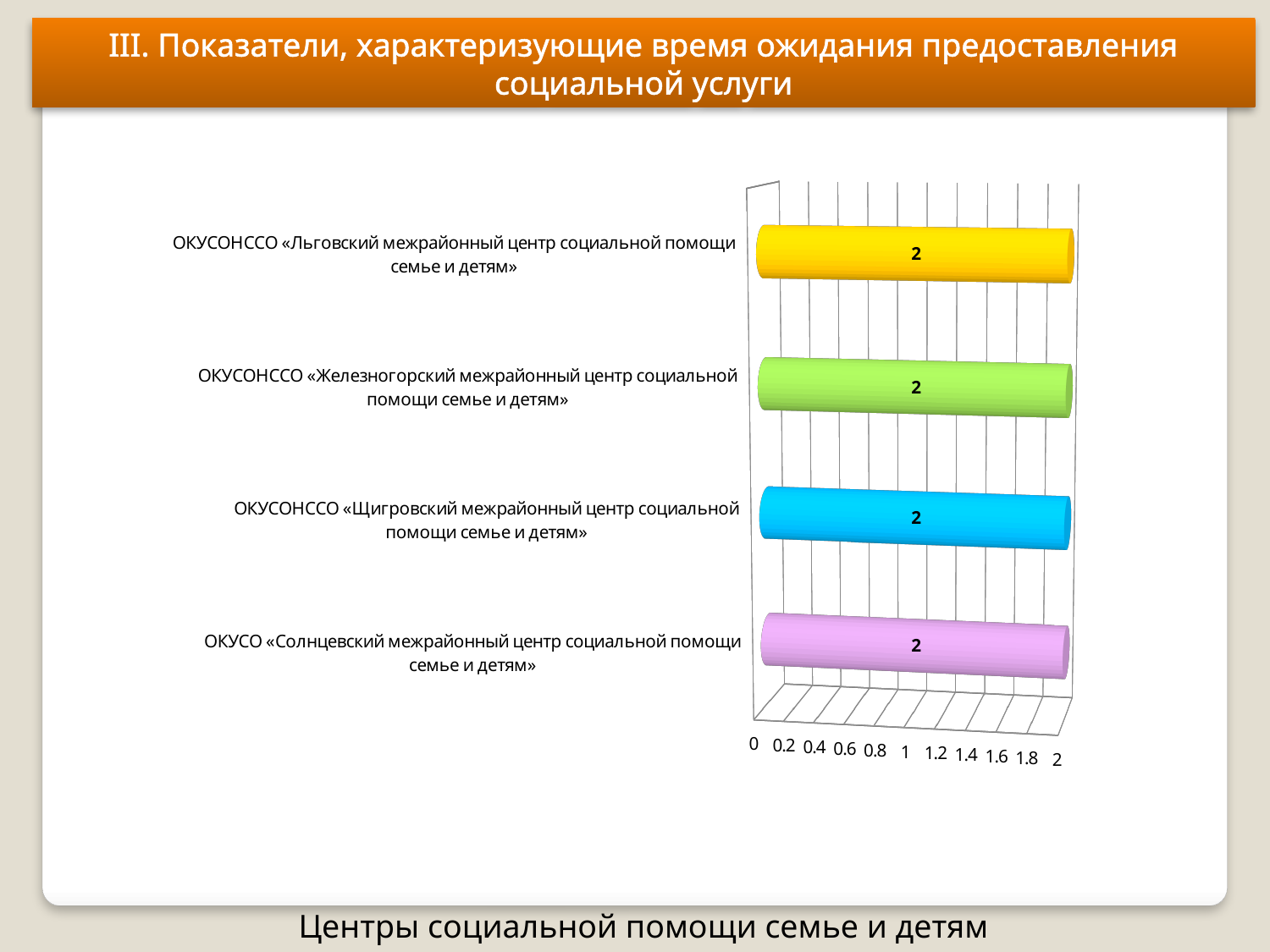
What is the value for ОКУСОНССО «Железногорский межрайонный центр социальной помощи семье и детям»? 2 What is the maximum value shown on the value axis of the chart? 2 What kind of chart is shown on the slide? Bar chart What is the value for ОКУСО «Солнцевский межрайонный центр социальной помощи семье и детям»? 2 What is the difference between the values for ОКУСОНССО «Льговский межрайонный центр социальной помощи семье и детям» and ОКУСО «Солнцевский межрайонный центр социальной помощи семье и детям»? 0 How many categories are shown in the chart? 4 What is the value for ОКУСОНССО «Щигровский межрайонный центр социальной помощи семье и детям»? 2 What is the value for ОКУСОНССО «Льговский межрайонный центр социальной помощи семье и детям»? 2 Is the value for ОКУСОНССО «Щигровский межрайонный центр социальной помощи семье и детям» greater or less than 1? greater What colour is the bar for ОКУСОНССО «Льговский межрайонный центр социальной помощи семье и детям»? Yellow Is the value for ОКУСОНССО «Железногорский межрайонный центр социальной помощи семье и детям» larger than, smaller than, or equal to the value for ОКУСО «Солнцевский межрайонный центр социальной помощи семье и детям»? Equal Do the values change from one category to the next in the chart? No, all values are 2